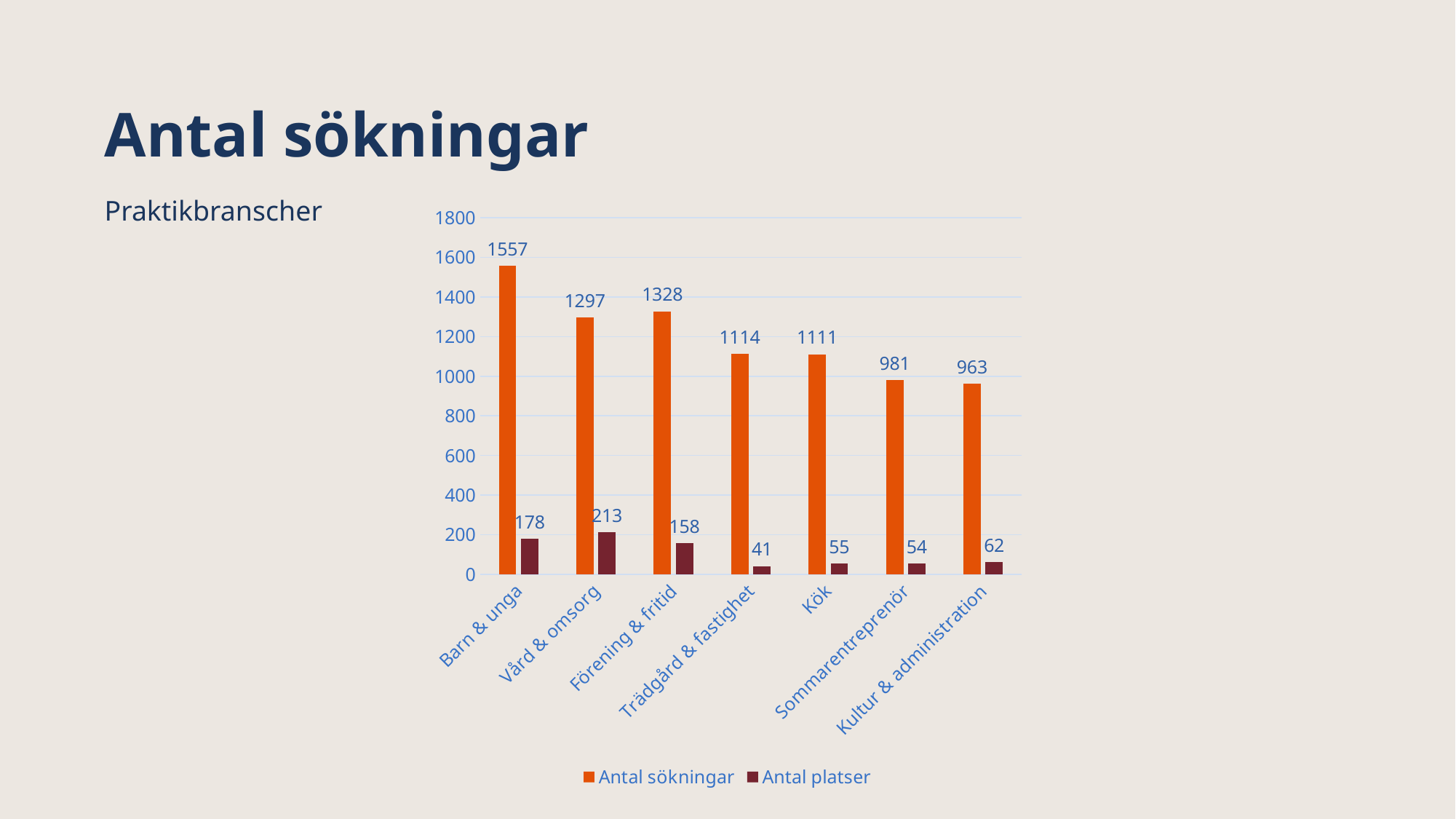
What are the two series named in the legend? Antal sökningar and Antal platser How many series does the legend list? 2 What is the value of Antal platser for Vård & omsorg? 213 What is the value of Antal sökningar for Kultur & administration? 963 What kind of chart is shown on the slide? bar chart Is the value of Antal sökningar for Sommarentreprenör greater or less than 1000? less What is the value of Antal sökningar for Barn & unga? 1557 What is the difference between Antal sökningar for Förening & fritid and Vård & omsorg? 31 Which is larger: Antal platser for Barn & unga or Antal platser for Förening & fritid? Barn & unga Which category has the lowest value for Antal platser? Trädgård & fastighet How many categories are shown on the x axis? 7 Which category has the highest value for Antal sökningar? Barn & unga